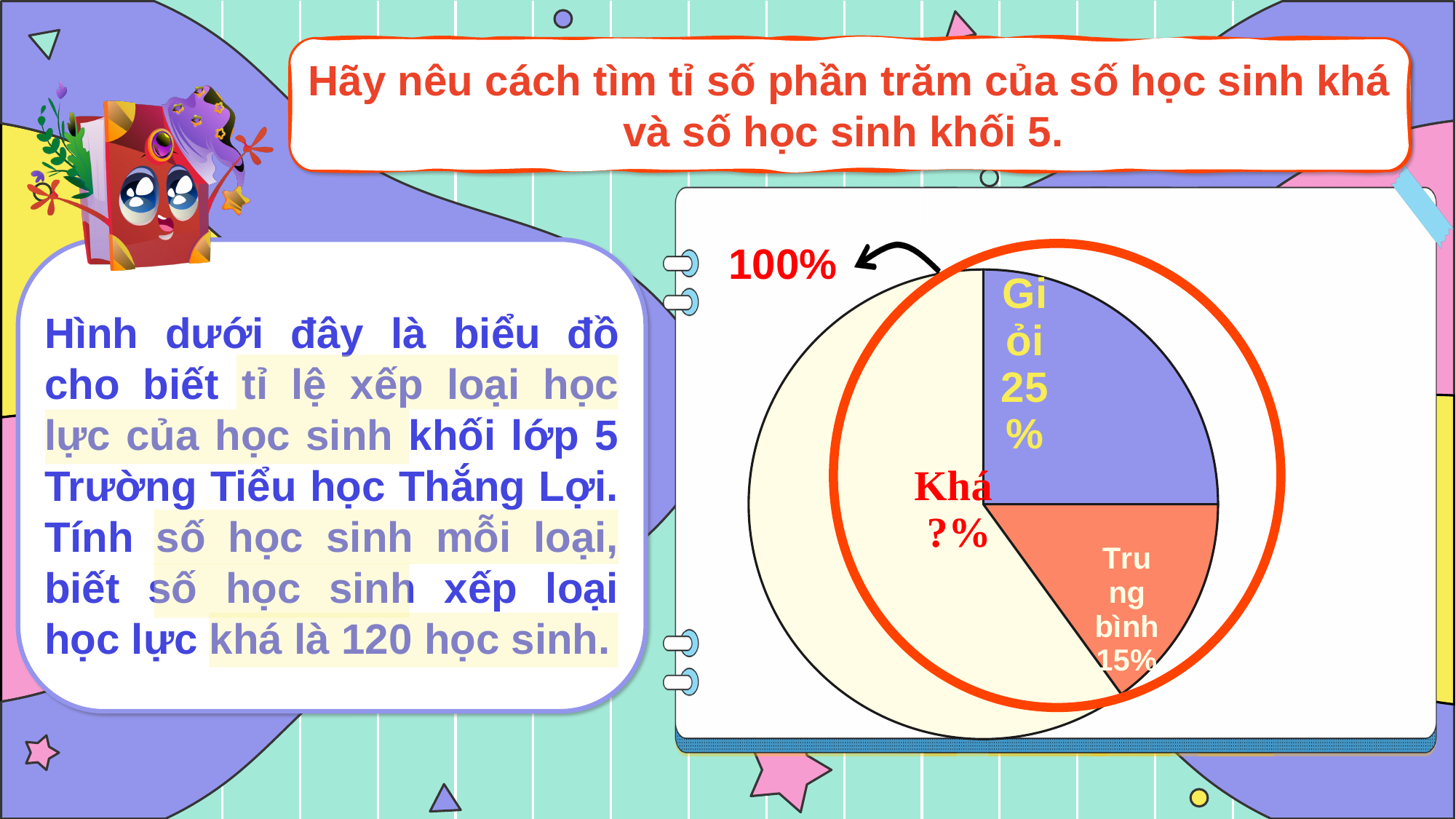
Which slice of the pie chart is the smallest? Trung bình What percentage is shown for the Trung bình slice of the pie chart? 15% How many slices does the pie chart have? 3 Which slice of the pie chart is the largest? Khá Given the whole pie is 100%, what share of the pie does the Khá slice represent? 60% What kind of chart is shown on the slide? pie chart What label is printed in place of the percentage on the Khá slice? ?% Which is larger in the pie chart, the Giỏi slice or the Trung bình slice? Giỏi What colour is the Trung bình slice of the pie chart? orange What is the difference between the Giỏi percentage and the Trung bình percentage in the pie chart? 10% What percentage is shown for the Giỏi slice of the pie chart? 25%